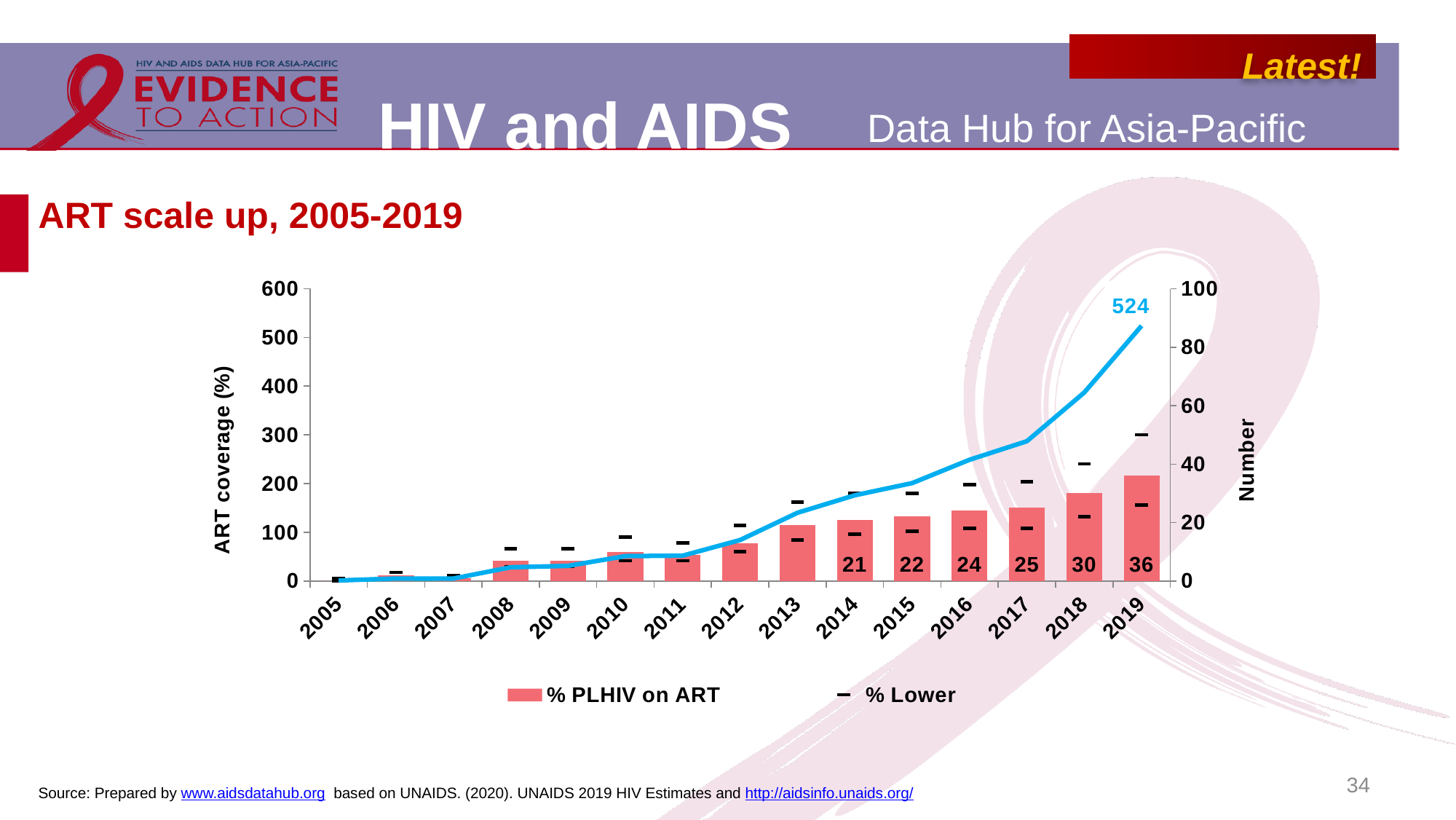
Which year has a higher % PLHIV on ART bar, 2016 or 2017? 2017 How many years are shown on the x axis? 15 What is the difference between the % PLHIV on ART values for 2018 and 2017? 5 What is the difference between the % PLHIV on ART values for 2019 and 2014? 15 What is the title of the chart? ART scale up, 2005-2019 Do the % PLHIV on ART bars rise or fall from 2005 to 2019? rise What is the % PLHIV on ART value for 2019? 36 What is the % PLHIV on ART value for 2018? 30 How many series does the legend list? 2 Which year has the highest % PLHIV on ART bar? 2019 What value is labelled on the blue line for 2019? 524 What is the % PLHIV on ART value for 2014? 21